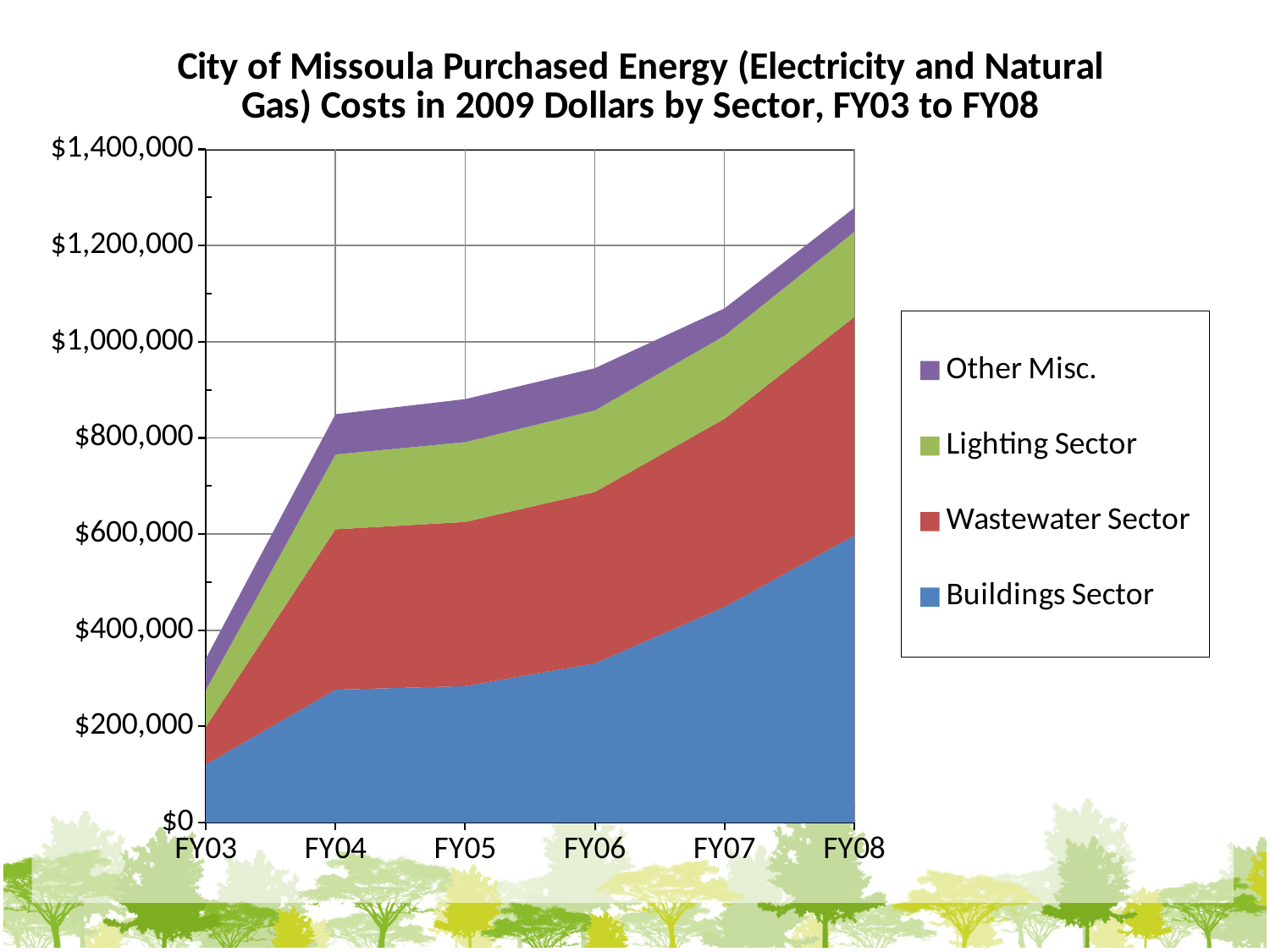
Do total purchased energy costs rise or fall from FY03 to FY08? Rise How many series does the legend list? 4 Is the total cost for FY06 greater or less than $1,000,000? less What kind of chart is shown on the slide? Stacked area chart Is the Buildings Sector cost for FY04 greater or less than $200,000? greater Which fiscal year has the highest total purchased energy cost? FY08 How many fiscal years are shown on the x axis? 6 Is the total cost for FY08 greater or less than $1,200,000? greater Which sector is shown as the bottom (blue) layer of the chart? Buildings Sector Which series is shown in green in the legend? Lighting Sector Which fiscal year has the lowest total purchased energy cost? FY03